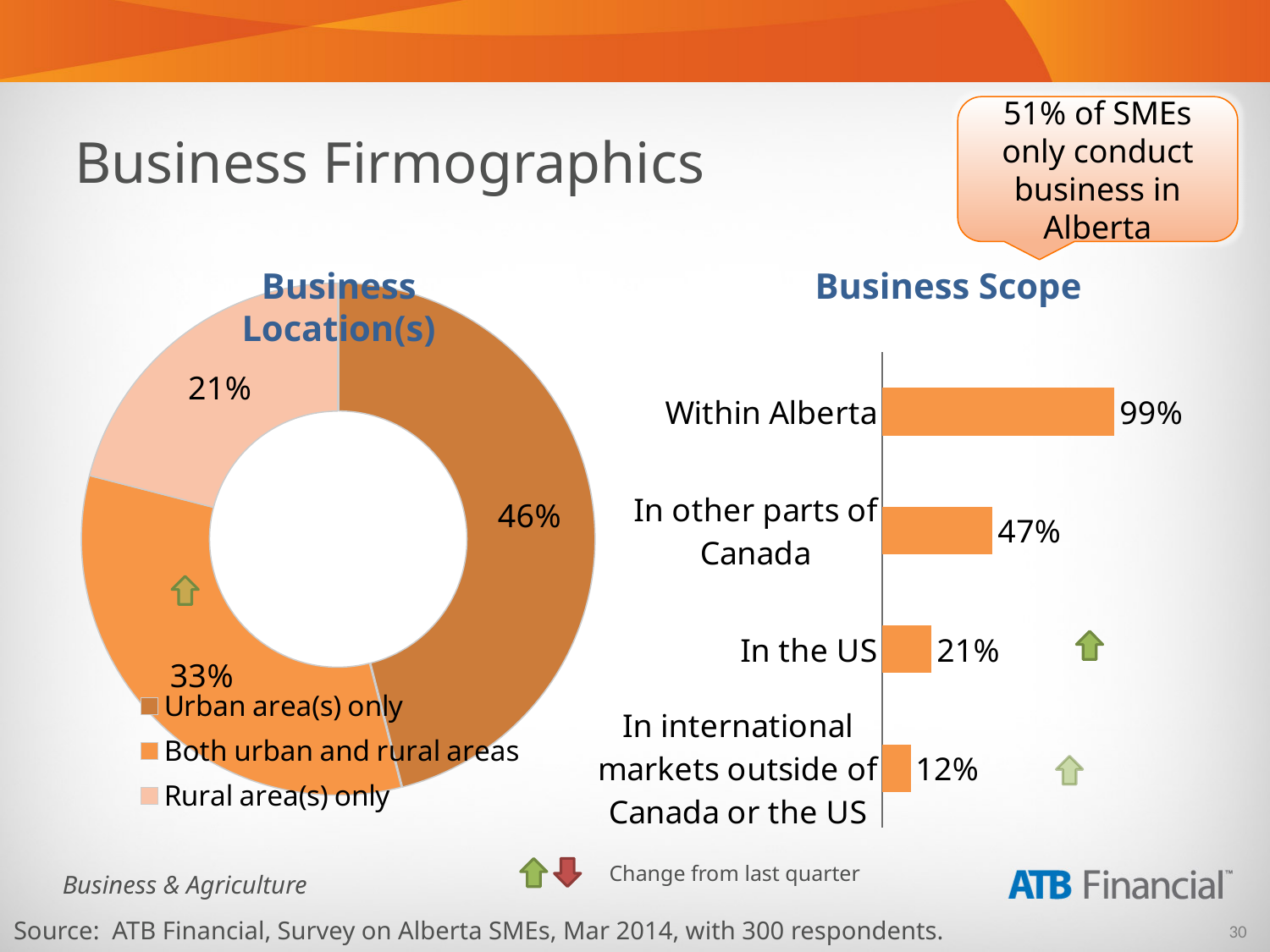
In the Business Location(s) chart, which category has the largest share? Urban area(s) only In the Business Scope chart, what is the value for In international markets outside of Canada or the US? 12% In the Business Location(s) chart, what is the difference between the shares for urban area(s) only and both urban and rural areas? 13% How many categories does the Business Location(s) chart legend list? 3 In the Business Location(s) chart, what percentage of SMEs operate in urban area(s) only? 46% What kind of chart is the Business Location(s) chart? Doughnut chart In the Business Location(s) chart, which category has the smallest share? Rural area(s) only What kind of chart is the Business Scope chart? Bar chart In the Business Location(s) chart, what percentage of SMEs operate in rural area(s) only? 21% In the Business Scope chart, which category has the highest value? Within Alberta In the Business Scope chart, what is the difference between Within Alberta and In the US? 78% In the Business Scope chart, what is the value for In other parts of Canada? 47%